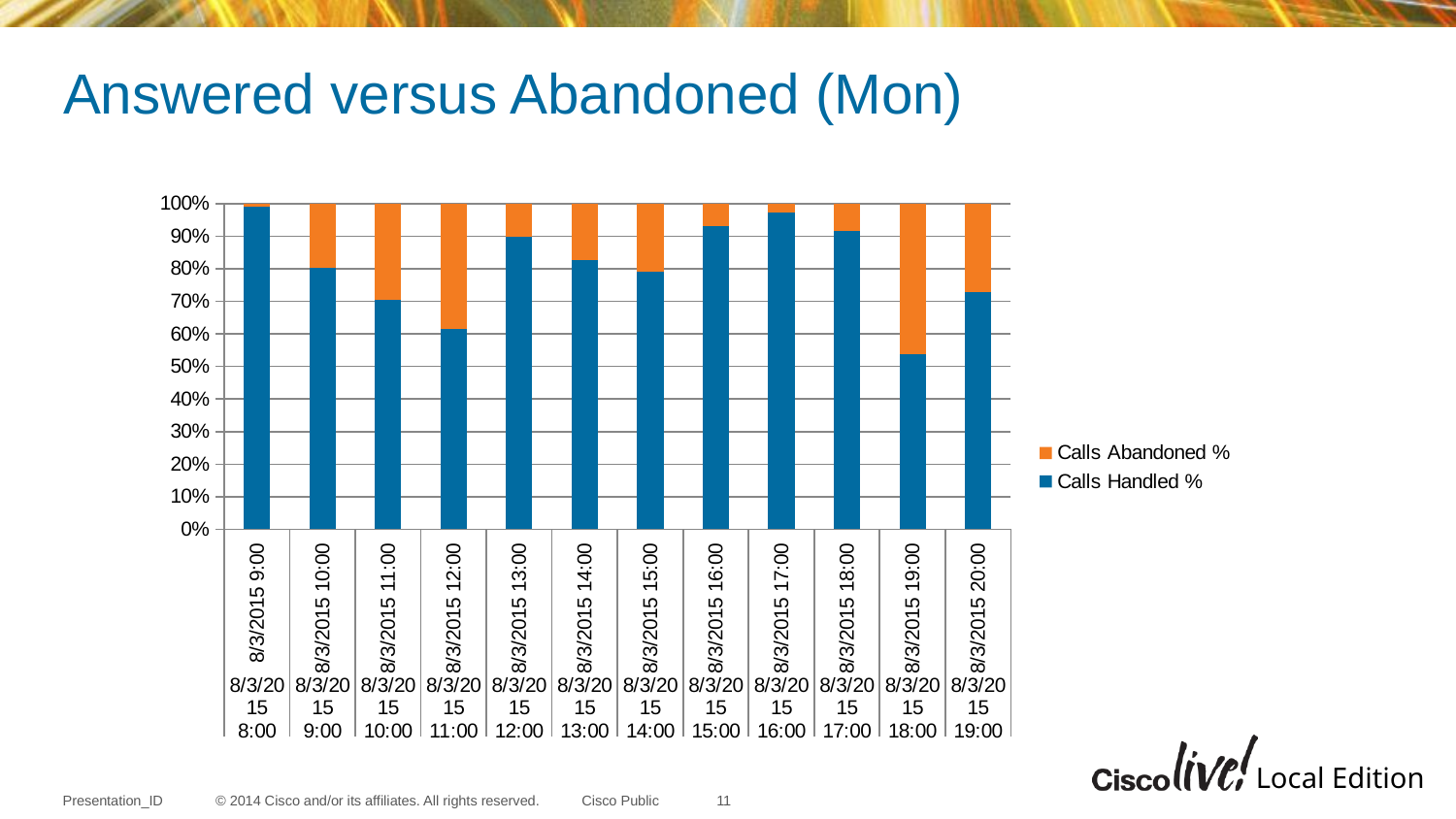
What is the title of the chart? Answered versus Abandoned (Mon) Is the Calls Handled % for the bar with rotated label 8/3/2015 12:00 (the fourth bar) greater or less than 70%? less Is the Calls Handled % for the bar with rotated label 8/3/2015 17:00 (the ninth bar) greater or less than 90%? greater Which has the larger Calls Handled %: the bar with rotated label 8/3/2015 10:00 (the second bar) or the bar with rotated label 8/3/2015 11:00 (the third bar)? 8/3/2015 10:00 (the second bar) Which colour represents Calls Abandoned % in the chart? Orange What kind of chart is shown on the slide? Stacked bar chart What is the total height of each stacked bar in the chart? 100% How many series does the chart's legend list? 2 How many hourly bars are plotted in the chart? 12 Which bar has the highest Calls Abandoned %? 8/3/2015 19:00 (the eleventh bar) Is the Calls Handled % for the bar with rotated label 8/3/2015 19:00 (the eleventh bar) greater or less than 60%? less Which bar has the lowest Calls Handled %? 8/3/2015 19:00 (the eleventh bar)